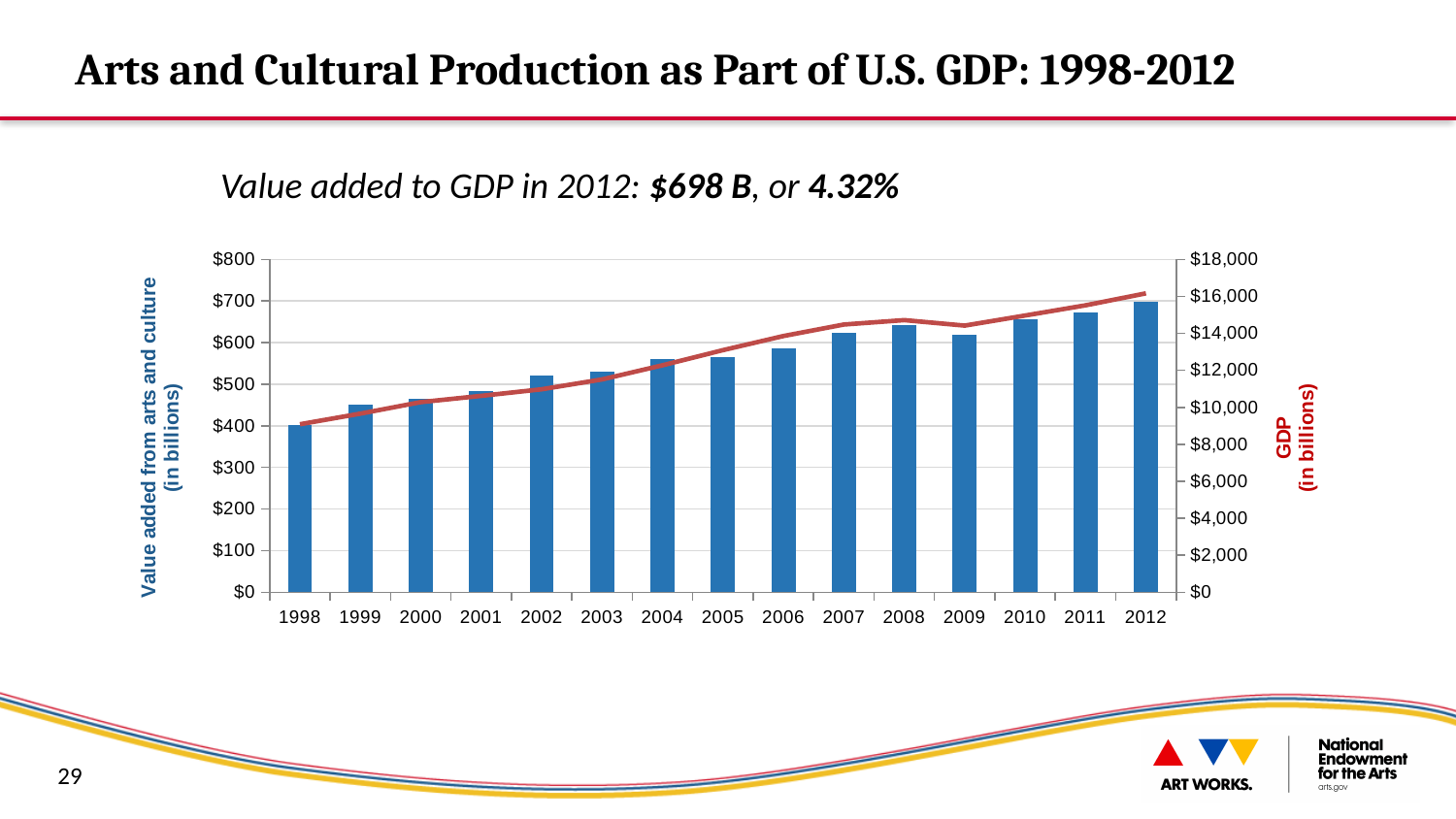
Which year has the larger bar for value added from arts and culture, 2009 or 2010? 2010 Do the bars for value added from arts and culture generally rise or fall from 1998 to 2012? rise Is the GDP line value for 1998 greater or less than $10,000? less What kind of chart is used to show the value added from arts and culture? bar chart What is the title of the right-hand vertical axis? GDP (in billions) How many years are shown along the x axis of the chart? 15 What colour is the line showing GDP? red Is the value added from arts and culture in 1998 greater or less than $500? less Is the value added from arts and culture in 2005 greater or less than $500? greater Which year has the highest bar for value added from arts and culture? 2012 According to the slide, what was the value added to GDP by arts and culture in 2012? $698 B Which year has the lowest bar for value added from arts and culture? 1998